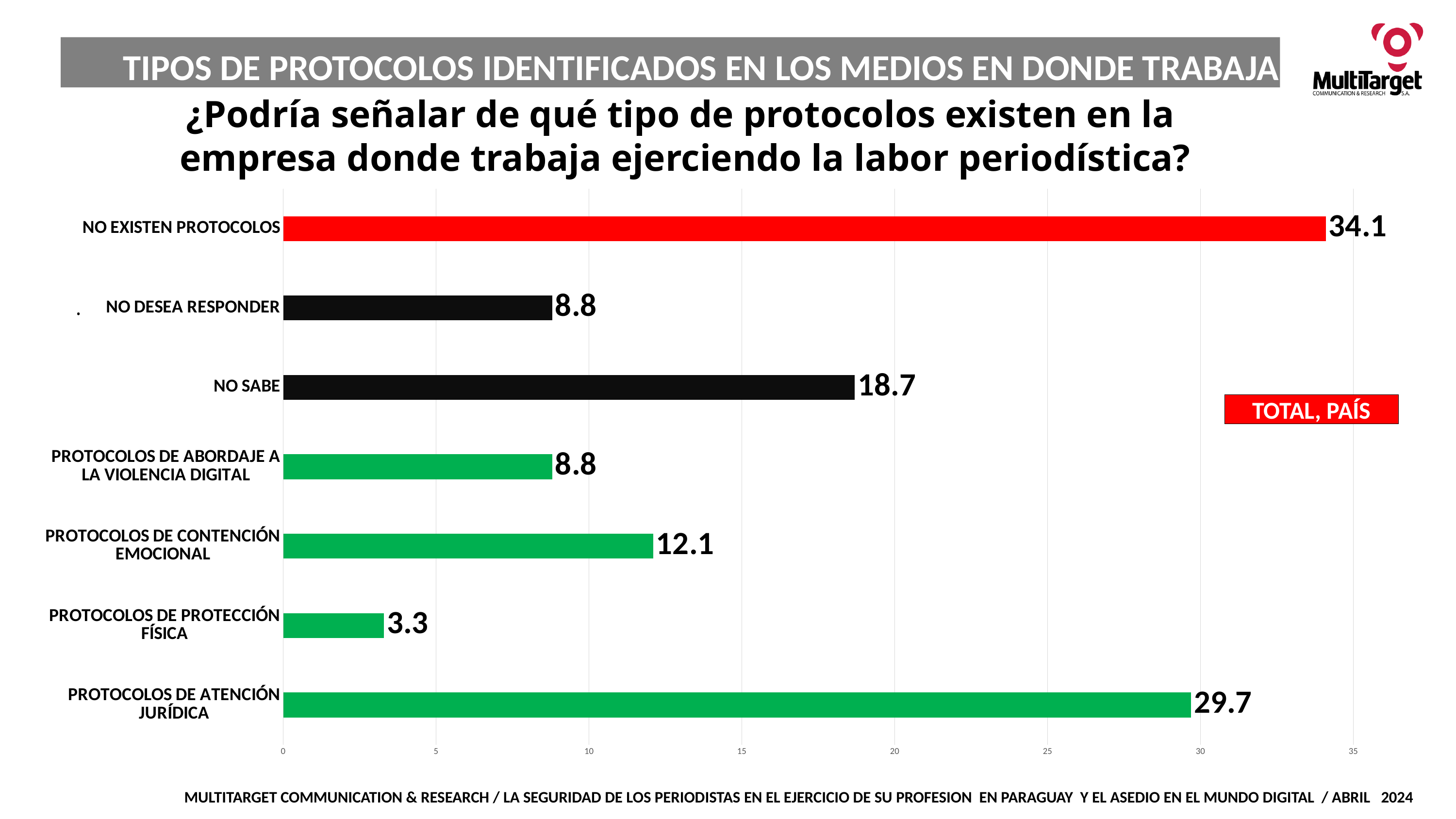
How many categories are shown in the chart? 7 Which category has the highest value? NO EXISTEN PROTOCOLOS What does the legend entry on the chart say? TOTAL, PAÍS What is the value for PROTOCOLOS DE ATENCIÓN JURÍDICA? 29.7 What is the difference between the values for NO EXISTEN PROTOCOLOS and PROTOCOLOS DE ATENCIÓN JURÍDICA? 4.4 What is the value for NO SABE? 18.7 What is the difference between the values for NO SABE and PROTOCOLOS DE CONTENCIÓN EMOCIONAL? 6.6 Which is larger, the value for NO SABE or the value for PROTOCOLOS DE CONTENCIÓN EMOCIONAL? NO SABE What is the value for PROTOCOLOS DE PROTECCIÓN FÍSICA? 3.3 What is the value for NO EXISTEN PROTOCOLOS? 34.1 What kind of chart is shown on the slide? Bar chart Which category has the lowest value? PROTOCOLOS DE PROTECCIÓN FÍSICA